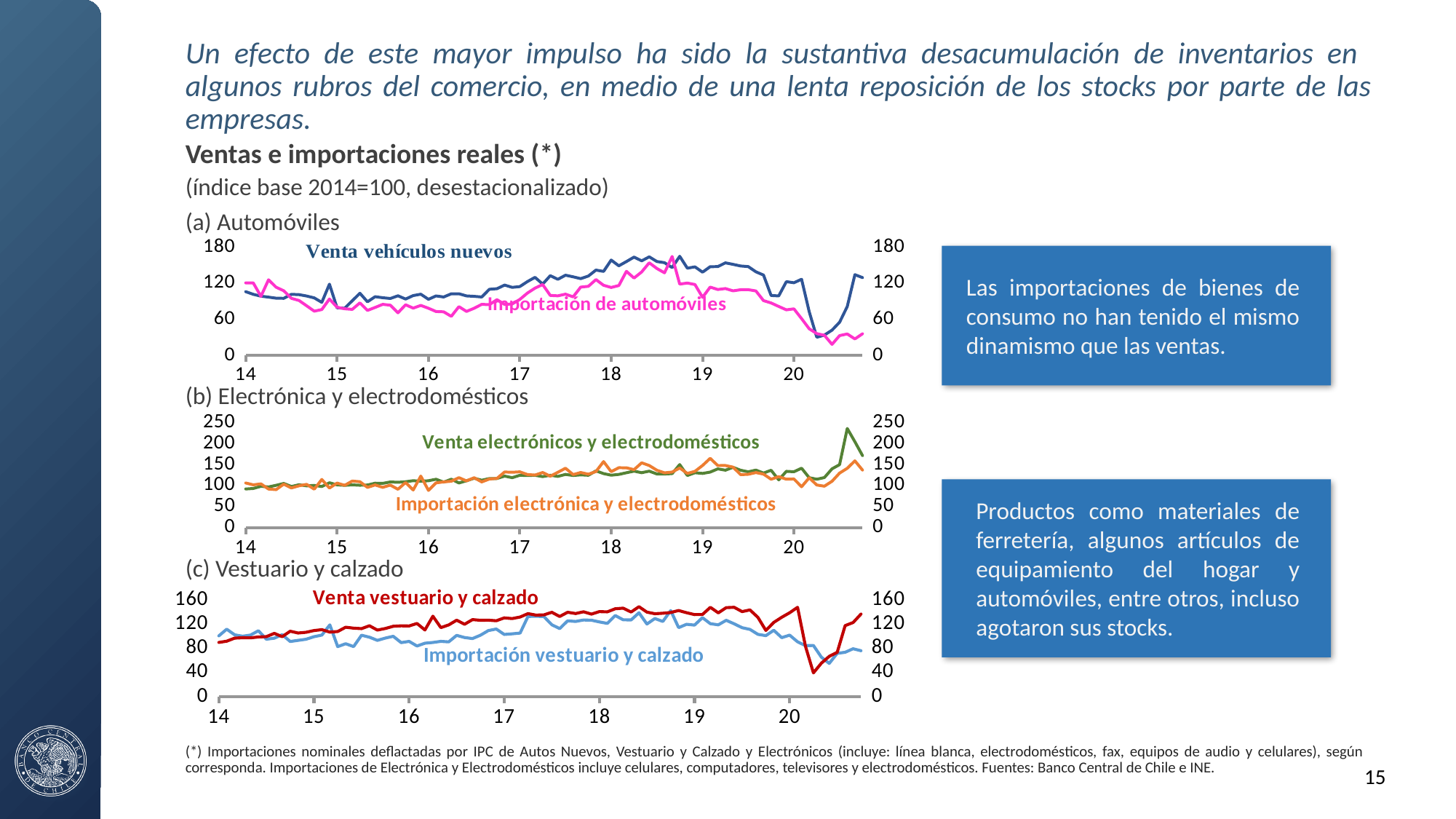
In panel (c) Vestuario y calzado, is the value of Venta vestuario y calzado at 18 greater or less than 120? greater In panel (a) Automóviles, does Venta vehículos nuevos rise or fall between 16 and 18? rise In panel (a) Automóviles, is the value of Venta vehículos nuevos at 18 greater or less than 120? greater What is the base year of the index used in the charts, as stated in the subtitle? 2014=100 In panel (a) Automóviles, at 19, which series is higher: Venta vehículos nuevos or Importación de automóviles? Venta vehículos nuevos In panel (c) Vestuario y calzado, what are the names of the two series? Venta vestuario y calzado and Importación vestuario y calzado How many series are plotted in panel (b) Electrónica y electrodomésticos? 2 How many year labels are shown on the x axis of panel (c) Vestuario y calzado? 7 In panel (b) Electrónica y electrodomésticos, is the peak value of Venta electrónicos y electrodomésticos near the end of the series greater or less than 200? greater What kind of chart is panel (a) Automóviles? line chart In panel (c) Vestuario y calzado, at 18, which series is higher: Venta vestuario y calzado or Importación vestuario y calzado? Venta vestuario y calzado